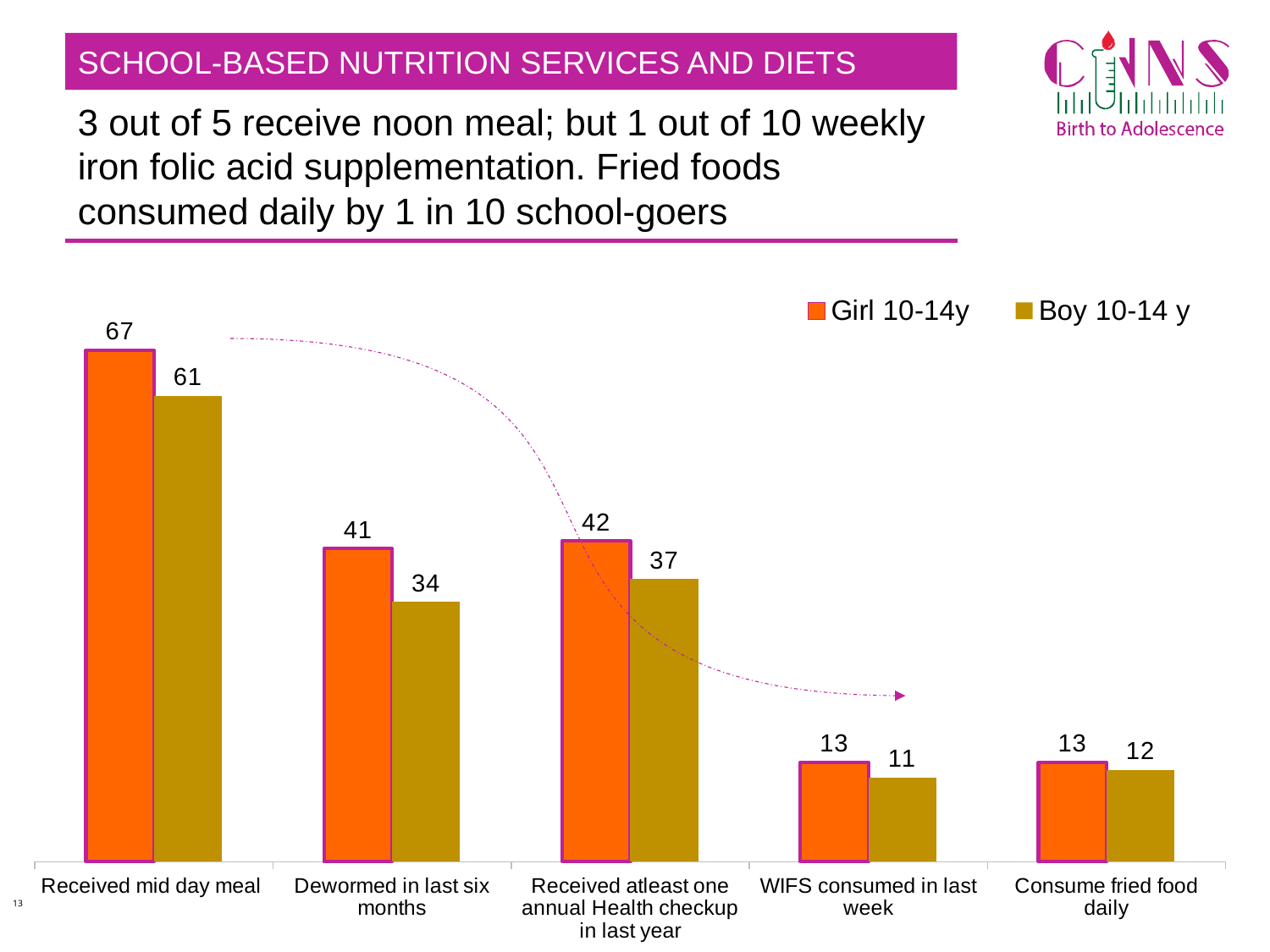
Which is larger for 'Dewormed in last six months': the Girl 10-14y value or the Boy 10-14 y value? Girl 10-14y What is the value for Boy 10-14 y for 'Received atleast one annual Health checkup in last year'? 37 What is the value for Boy 10-14 y for 'Dewormed in last six months'? 34 Which category has the highest value for Girl 10-14y? Received mid day meal What is the value for Girl 10-14y for 'Received mid day meal'? 67 What kind of chart is shown on the slide? Bar chart Which category has the lowest value for Boy 10-14 y? WIFS consumed in last week What is the value for Girl 10-14y for 'WIFS consumed in last week'? 13 How many categories are shown on the x axis? 5 What are the two series named in the legend? Girl 10-14y and Boy 10-14 y How many series does the legend list? 2 What is the difference between the Girl 10-14y and Boy 10-14 y values for 'Received mid day meal'? 6